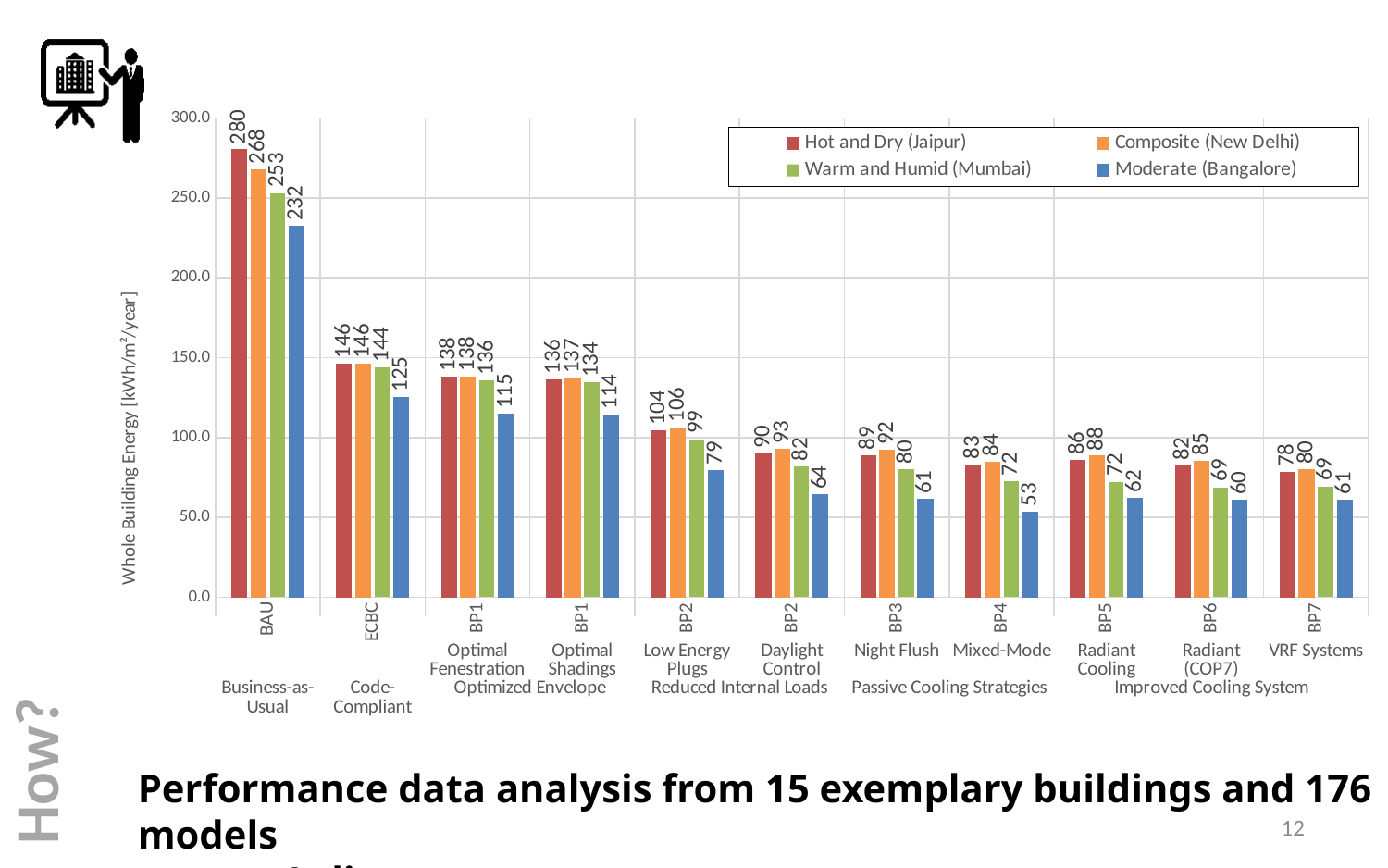
What is the label of the y axis? Whole Building Energy [kWh/m²/year] What is the value for Moderate (Bangalore) in the ECBC (Code-Compliant) category? 125 Which is larger for Night Flush (BP3): the Composite (New Delhi) value or the Warm and Humid (Mumbai) value? Composite (New Delhi) What is the value for Composite (New Delhi) for VRF Systems (BP7)? 80 What kind of chart is shown on the slide? Bar chart How many series does the legend list? 4 What is the difference between the Hot and Dry (Jaipur) and Moderate (Bangalore) values in the BAU category? 48 Which category has the highest value for Moderate (Bangalore)? BAU Which category has the lowest value for Moderate (Bangalore)? Mixed-Mode (BP4) What is the value for Hot and Dry (Jaipur) in the BAU (Business-as-Usual) category? 280 How many categories are shown on the x axis? 11 What is the value for Warm and Humid (Mumbai) for Daylight Control (BP2)? 82